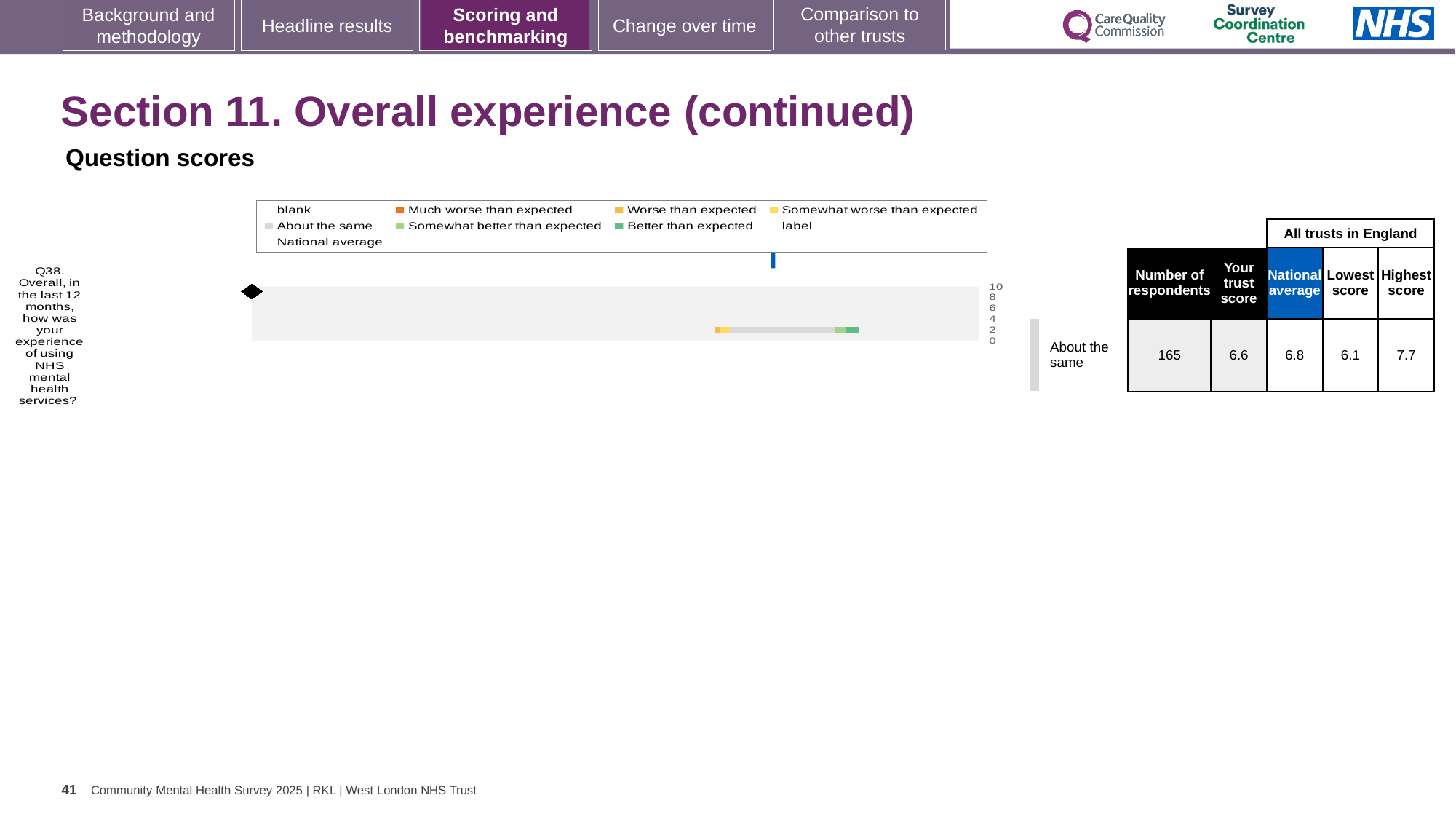
Which survey question is plotted in the chart on this slide? Q38 What is the 'Your trust score' value for Q38? 6.6 How many respondents answered Q38? 165 What is the lowest score among all trusts in England for Q38? 6.1 For Q38, what is the difference between the highest score and the lowest score among all trusts in England? 1.6 What is the highest score among all trusts in England for Q38? 7.7 For Q38, which is larger: the trust score or the national average? National average How many survey questions are plotted in the chart on this slide? 1 What kind of chart is shown on the slide for Q38? bar chart What is the national average score for Q38? 6.8 What benchmark category label is shown next to the chart for Q38? About the same